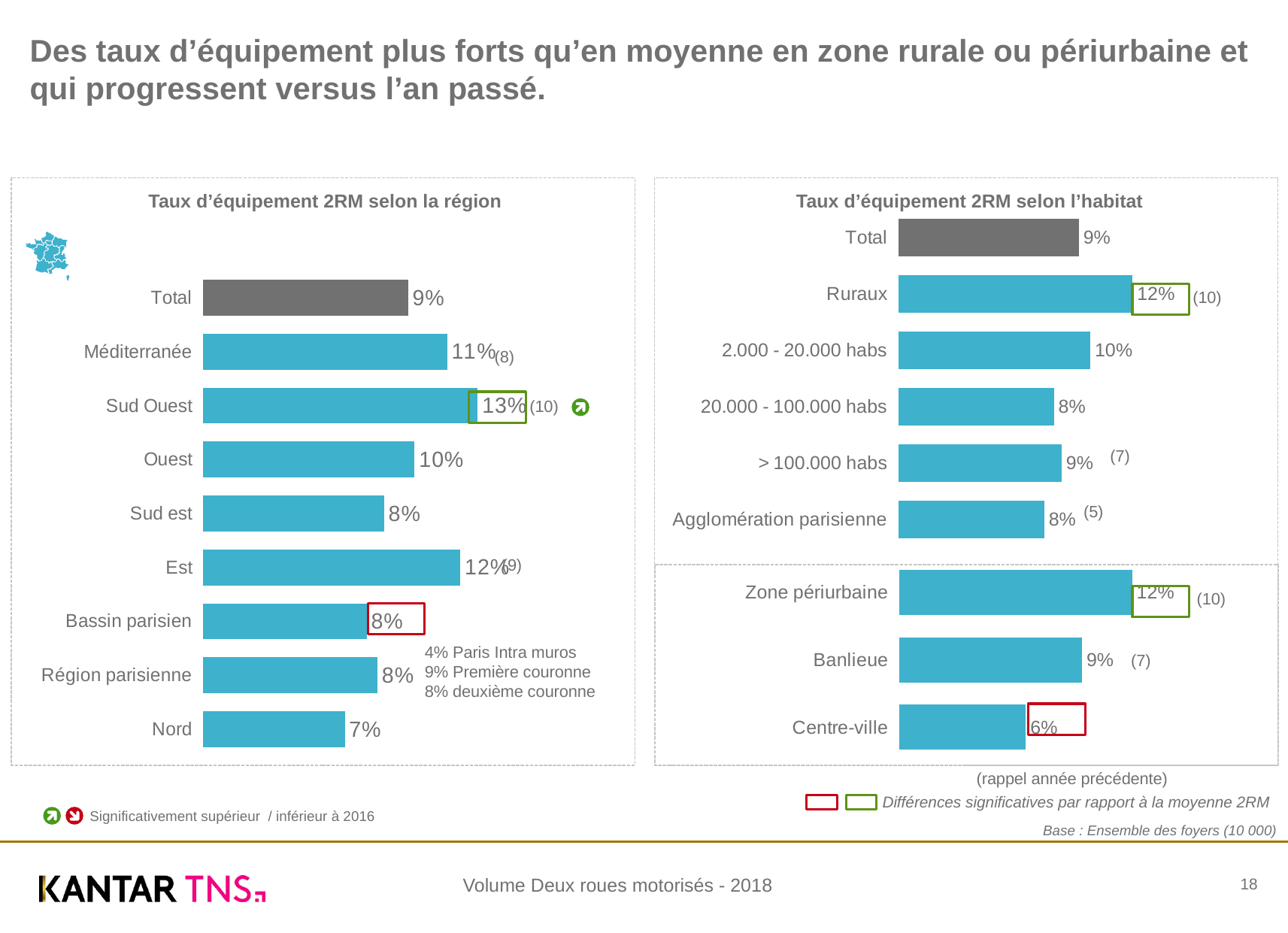
In the chart 'Taux d’équipement 2RM selon la région', what is the value for Sud Ouest? 13% In the chart 'Taux d’équipement 2RM selon l’habitat', what is the value for 2.000 - 20.000 habs? 10% In the chart 'Taux d’équipement 2RM selon l’habitat', what is the value for Centre-ville? 6% In the chart 'Taux d’équipement 2RM selon la région', which region has the lowest value? Nord In the chart 'Taux d’équipement 2RM selon l’habitat', which category has the lowest value? Centre-ville What kind of chart is 'Taux d’équipement 2RM selon l’habitat'? Bar chart In the chart 'Taux d’équipement 2RM selon la région', what is the difference between Est and Nord? 5% In the chart 'Taux d’équipement 2RM selon l’habitat', what is the difference between Zone périurbaine and Centre-ville? 6% In the chart 'Taux d’équipement 2RM selon la région', which region has the highest value? Sud Ouest In the chart 'Taux d’équipement 2RM selon la région', how many bars are plotted? 9 In the chart 'Taux d’équipement 2RM selon l’habitat', which is larger, Ruraux or Banlieue? Ruraux In the chart 'Taux d’équipement 2RM selon la région', what is the value for Total? 9%